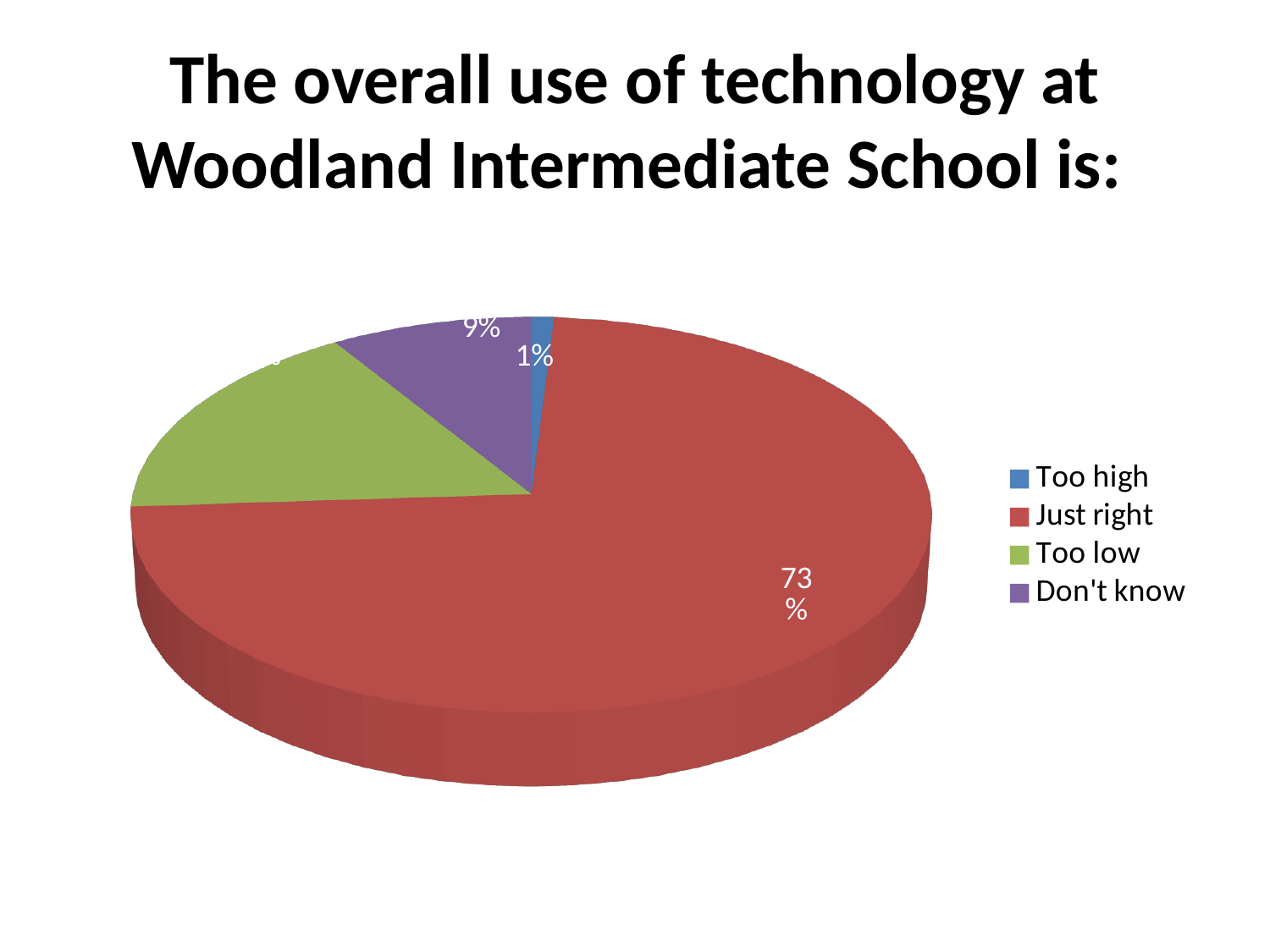
How many percentage points larger is the "Just right" share than the "Don't know" share? 64% Which response has the smallest share of the pie? Too high How many response categories does the pie chart show? 4 What is the difference between the "Don't know" share and the "Too high" share? 8% What percentage of respondents said the use of technology is "Too high"? 1% What percentage of respondents said the overall use of technology is "Just right"? 73% What percentage of respondents answered "Don't know"? 9% What type of chart is shown on the slide? Pie chart Which slice is larger, "Too low" or "Don't know"? Too low Which response has the largest share of the pie? Just right What colour is the "Just right" slice in the pie chart? Red Which is larger, the share for "Just right" or the share for "Don't know"? Just right